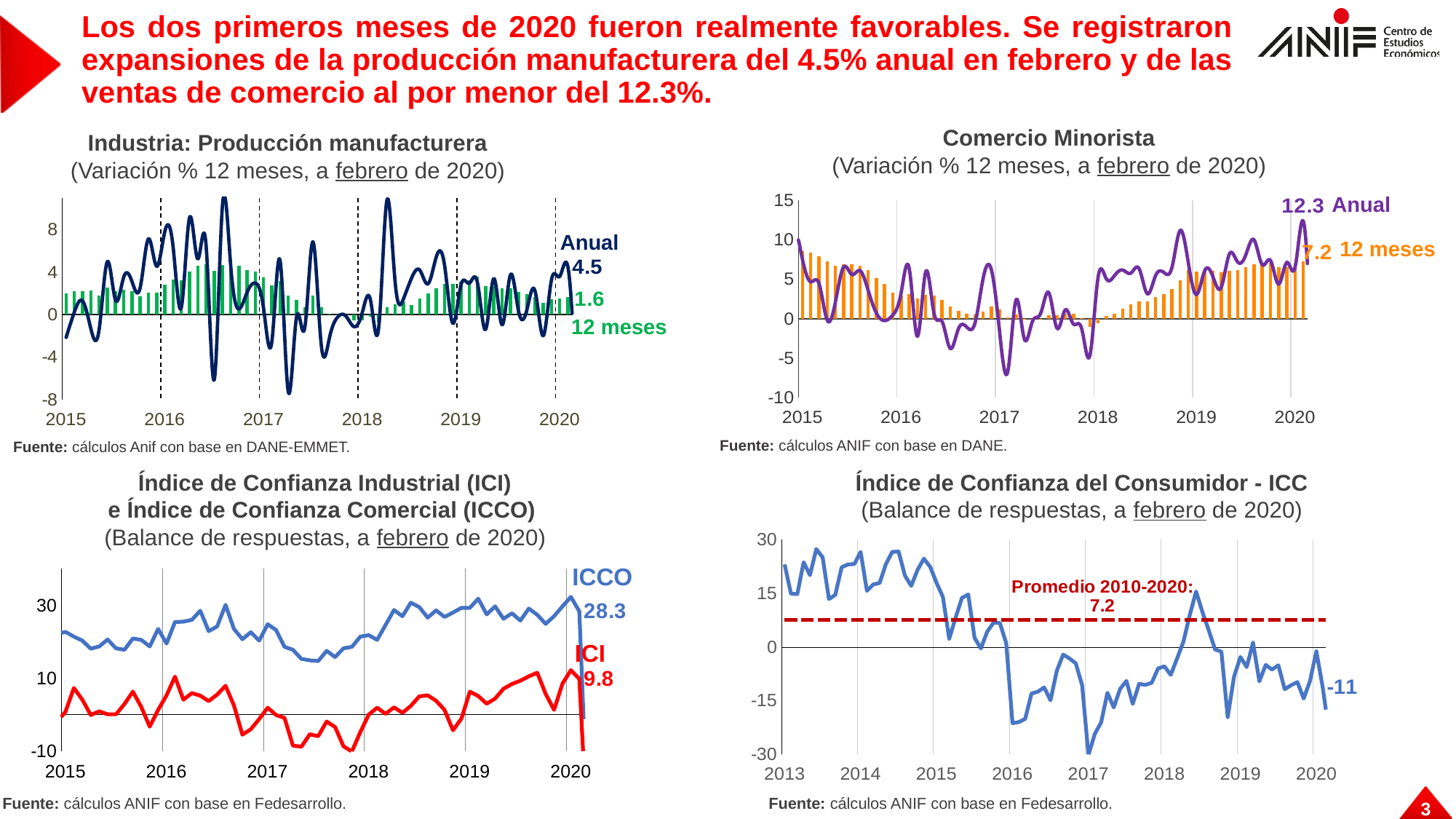
In the 'Industria: Producción manufacturera' chart, what is the labelled value of the 'Anual' series at February 2020? 4.5 In the ICI and ICCO chart, what is the difference between the labelled ICCO value (28.3) and the ICI value (9.8)? 18.5 In the ICI and ICCO chart, what is the labelled value of ICI at February 2020? 9.8 In the 'Índice de Confianza del Consumidor - ICC' chart, which is larger: the February 2020 value or the 'Promedio 2010-2020'? Promedio 2010-2020 In the 'Comercio Minorista' chart, what is the labelled value of the '12 meses' series at February 2020? 7.2 In the 'Comercio Minorista' chart, what is the labelled value of the 'Anual' series at February 2020? 12.3 In the 'Industria: Producción manufacturera' chart, what is the labelled value of the '12 meses' series at February 2020? 1.6 In the 'Comercio Minorista' chart, which series is drawn as bars rather than a line? 12 meses In the 'Índice de Confianza del Consumidor - ICC' chart, what is the value of the 'Promedio 2010-2020' shown by the dashed line? 7.2 In the ICI and ICCO chart, what is the labelled value of ICCO at February 2020? 28.3 In the 'Índice de Confianza del Consumidor - ICC' chart, what is the labelled value at February 2020? -11 In the 'Comercio Minorista' chart, what is the difference between the labelled 'Anual' value (12.3) and the '12 meses' value (7.2)? 5.1